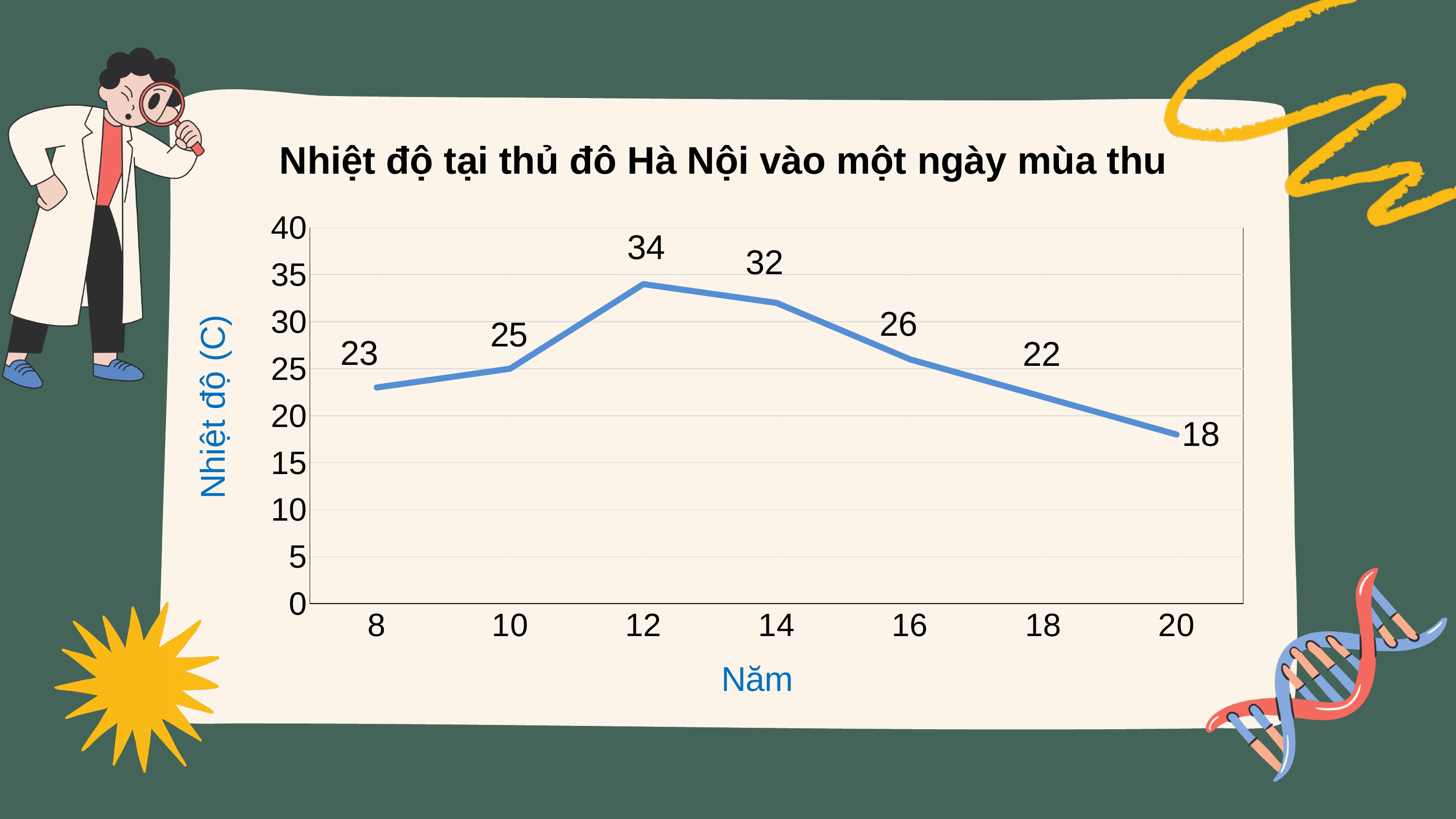
What is the difference between the temperature at 14 and the temperature at 16? 6 Does the temperature rise or fall between 12 and 20 on the x axis? fall What is the temperature at 12 on the x axis? 34 What is the temperature at 20 on the x axis? 18 What is the temperature at 8 on the x axis? 23 At which x-axis value is the temperature lowest? 20 Which is larger, the temperature at 10 or the temperature at 18? 10 What is the difference between the temperature at 12 and the temperature at 20? 16 What is the title of the chart? Nhiệt độ tại thủ đô Hà Nội vào một ngày mùa thu How many data points are plotted on the line? 7 At which x-axis value is the temperature highest? 12 What kind of chart is shown on the slide? line chart